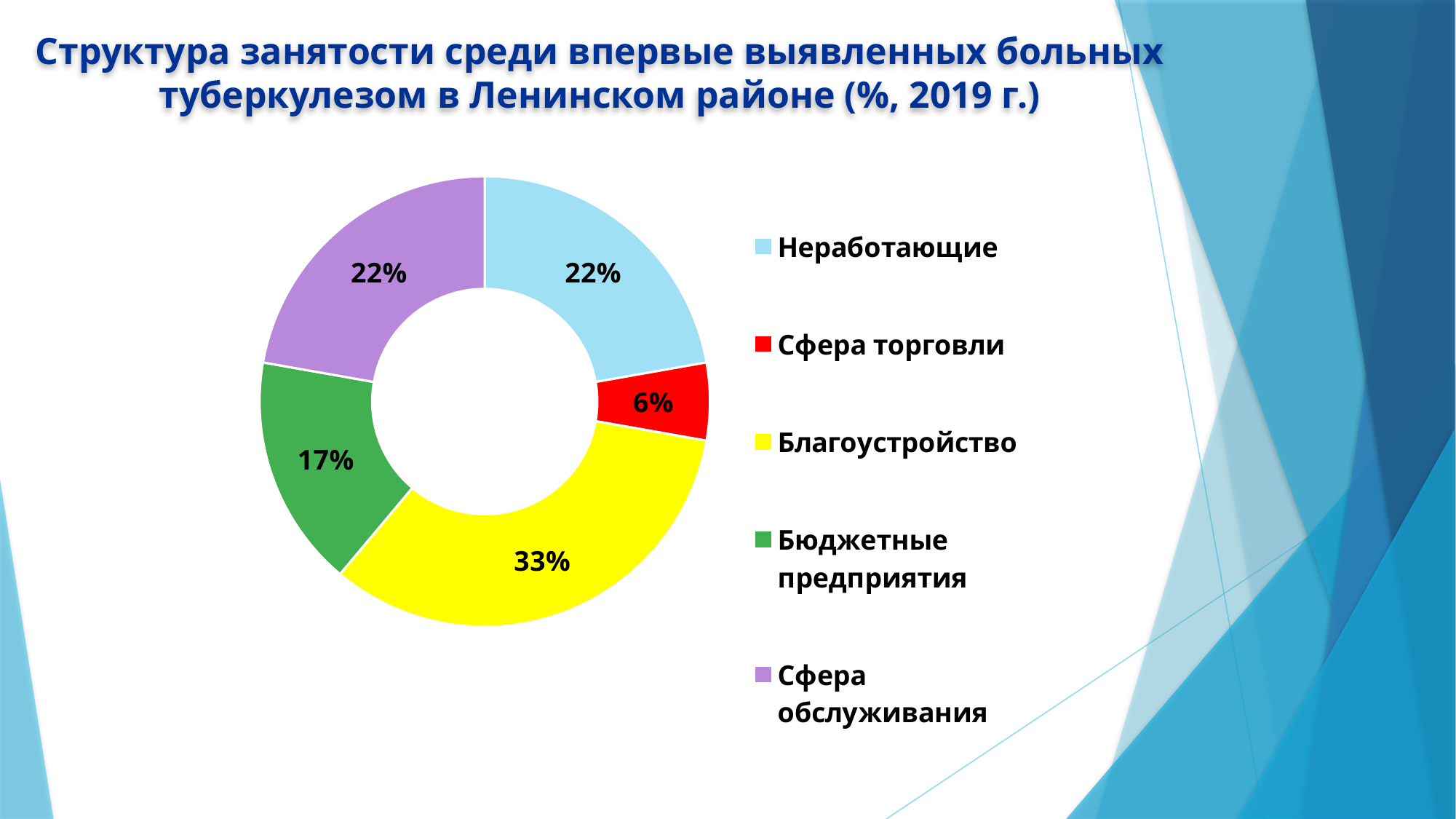
What colour represents Сфера торговли in the chart? Red What share of the chart does Благоустройство account for? 33% What is the value shown for Сфера торговли? 6% Which category has the smallest share? Сфера торговли How many categories does the chart show? 5 What year does the chart title refer to? 2019 Which category has the largest share? Благоустройство What is the value shown for Бюджетные предприятия? 17% What is the difference between the shares of Благоустройство and Бюджетные предприятия? 16% What kind of chart is shown on the slide? Doughnut (pie) chart What is the value shown for Неработающие? 22% Which is larger, the share of Сфера обслуживания or the share of Бюджетные предприятия? Сфера обслуживания